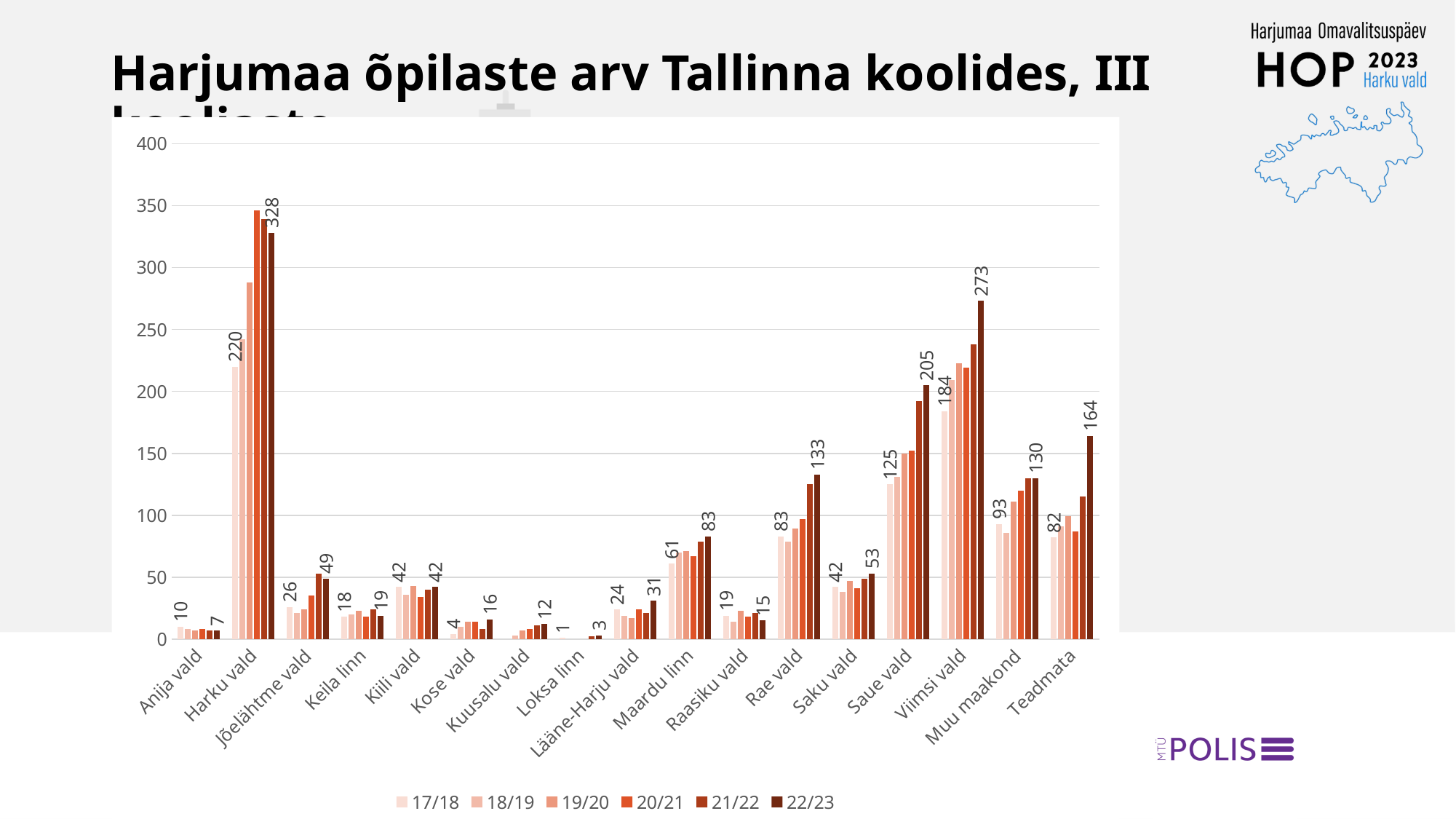
What is the value for Saue vald in the 22/23 series? 205 Which series is shown in the darkest colour in the legend? 22/23 What is the value for Harku vald in the 22/23 series? 328 Is the 21/22 value for Harku vald greater or less than 300? greater Which is larger for Teadmata: the 17/18 value or the 22/23 value? 22/23 What is the difference between the 22/23 and 17/18 values for Rae vald? 50 Which category has the highest value in the 22/23 series? Harku vald What kind of chart is shown on the slide? bar chart What is the value for Viimsi vald in the 17/18 series? 184 How many series does the legend list? 6 Which category has the lowest value in the 17/18 series among those with a printed label? Loksa linn How many categories are shown on the x axis? 17